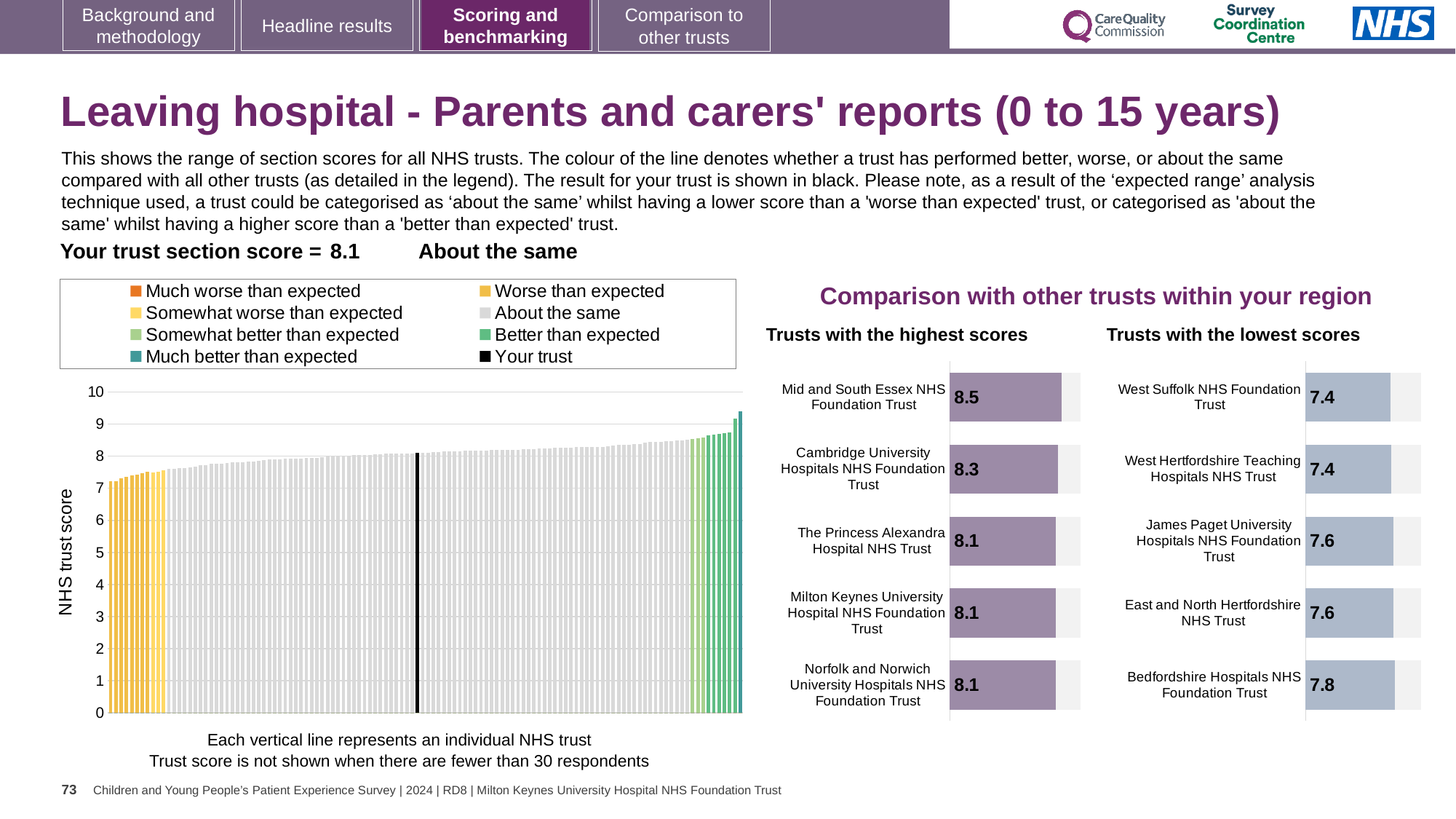
In the 'Trusts with the lowest scores' chart, what is the difference between Bedfordshire Hospitals NHS Foundation Trust and West Suffolk NHS Foundation Trust? 0.4 In the 'Trusts with the lowest scores' chart, what is the value for Bedfordshire Hospitals NHS Foundation Trust? 7.8 What kind of chart is the large chart on the left with the y axis labelled 'NHS trust score'? bar chart In the 'NHS trust score' chart on the left, is the value of the shortest bar greater or less than 8? less In the 'Trusts with the highest scores' chart, which trust has the highest score? Mid and South Essex NHS Foundation Trust In the 'Trusts with the highest scores' chart, what is the value for Mid and South Essex NHS Foundation Trust? 8.5 In the 'Trusts with the highest scores' chart, what is the difference between Mid and South Essex NHS Foundation Trust and Cambridge University Hospitals NHS Foundation Trust? 0.2 In the 'Trusts with the highest scores' chart, how many trusts are shown? 5 In the 'NHS trust score' chart on the left, how many entries does the legend list? 8 In the 'NHS trust score' chart on the left, what is the label on the y axis? NHS trust score In the 'Trusts with the lowest scores' chart, which trust has the highest score? Bedfordshire Hospitals NHS Foundation Trust In the 'NHS trust score' chart on the left, is the value of the tallest bar greater or less than 9? greater